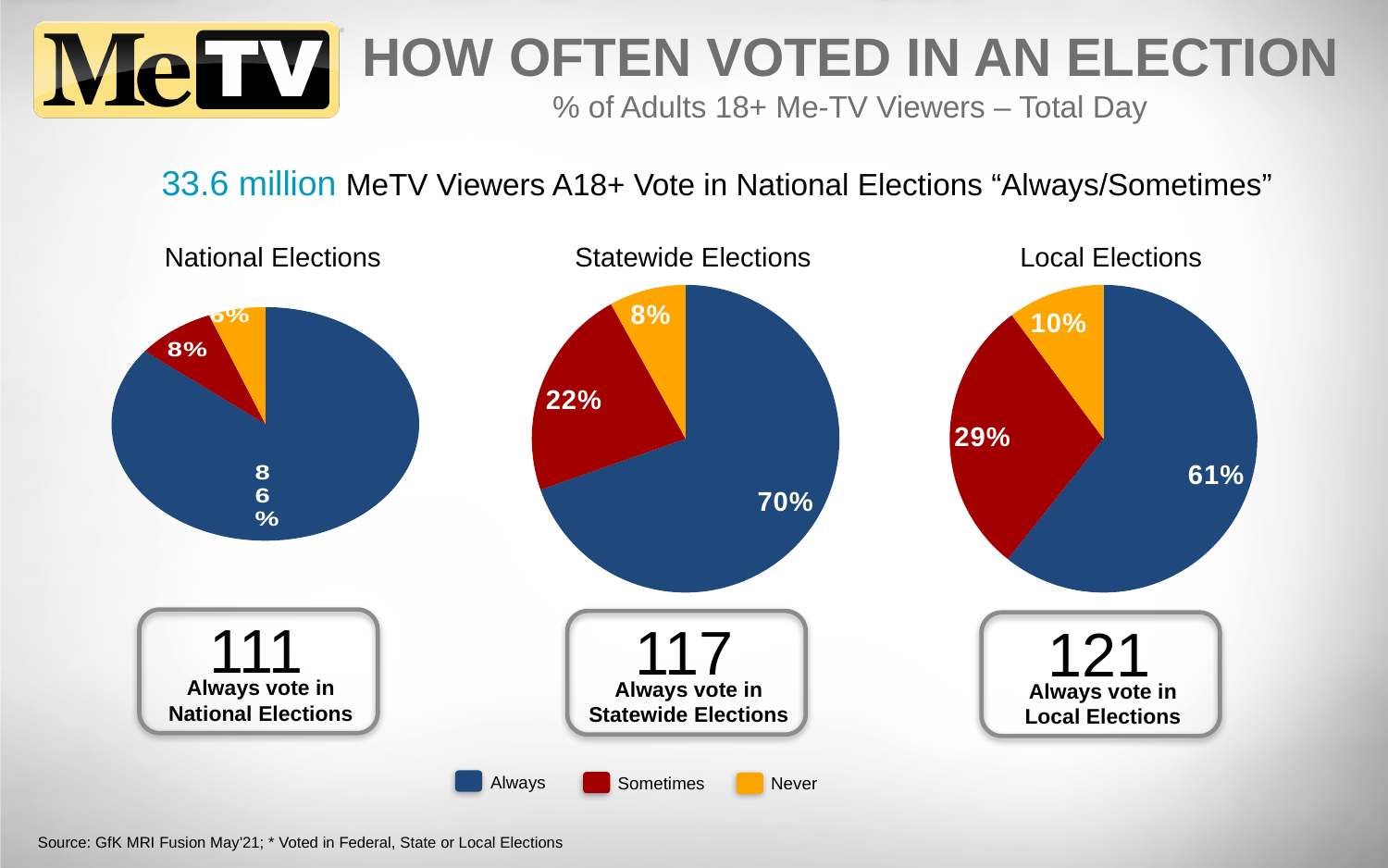
In the Local Elections pie chart, what is the difference between the Always share and the Sometimes share? 32% In the Local Elections pie chart, what percentage of Me-TV viewers say they Never vote? 10% What type of chart is used to show how often Me-TV viewers voted in Local Elections? Pie chart In the National Elections pie chart, what percentage of Me-TV viewers say they Sometimes vote? 8% In the Statewide Elections pie chart, what percentage of Me-TV viewers say they Always vote? 70% How many categories does the legend at the bottom of the slide list? 3 In the Local Elections pie chart, which category has the largest share? Always How many slices does the Statewide Elections pie chart have? 3 In the Local Elections pie chart, what percentage of Me-TV viewers say they Sometimes vote? 29% In the Statewide Elections pie chart, which category has the smallest share? Never In the Statewide Elections pie chart, what percentage of Me-TV viewers say they Sometimes vote? 22% Is the Always share larger in the Statewide Elections pie chart or the Local Elections pie chart? Statewide Elections